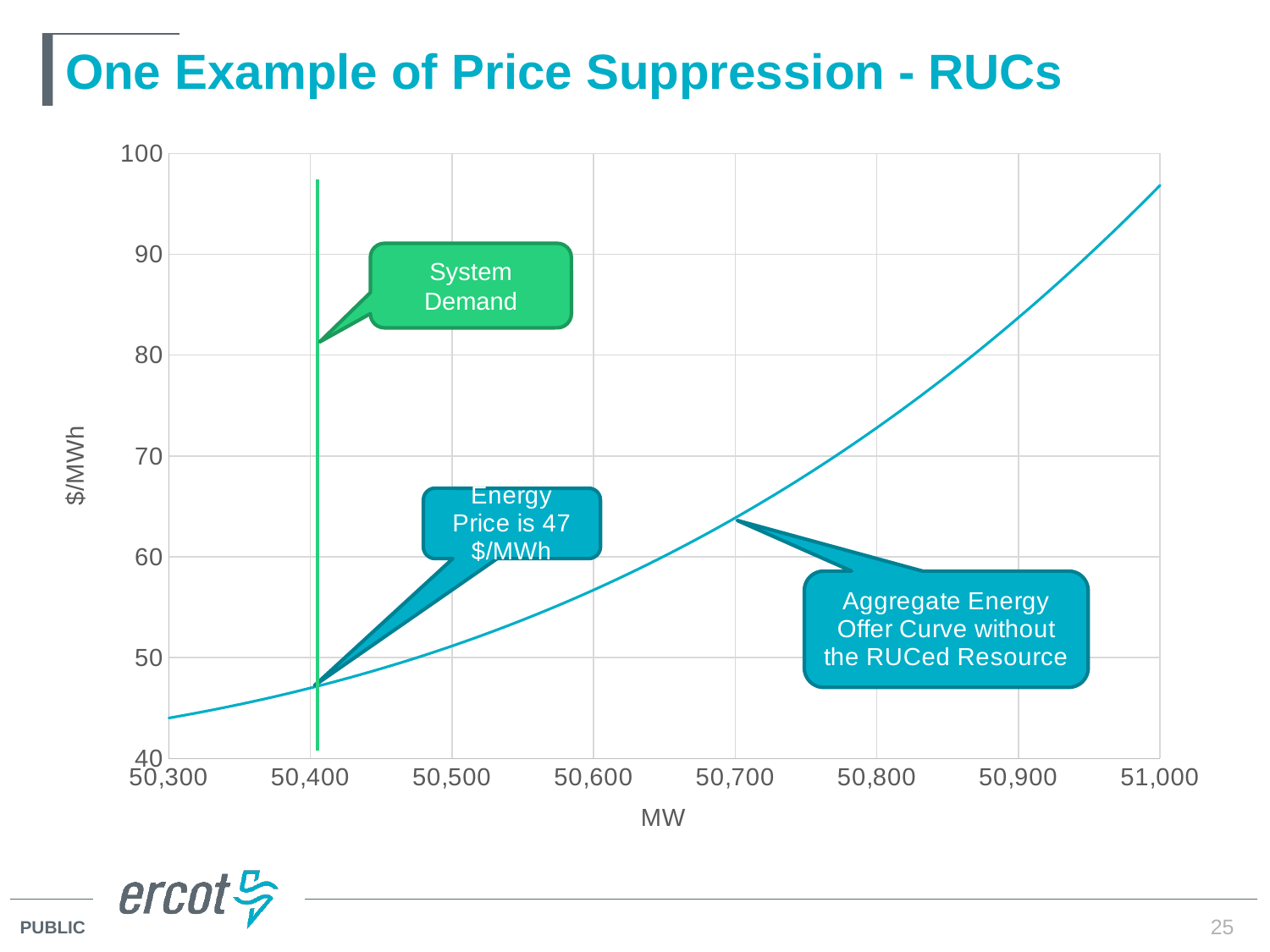
What is the label of the y axis? $/MWh What does the vertical green line on the chart represent, according to its callout? System Demand Is the value of the offer curve at 50,500 MW greater or less than 60 $/MWh? less What kind of chart is shown on the slide? line chart Is the value of the offer curve at 50,300 MW greater or less than 50 $/MWh? less How many tick labels are shown on the x axis? 8 Is the value of the offer curve at 51,000 MW greater or less than 90 $/MWh? greater Which is higher on the offer curve: the value at 50,800 MW or the value at 50,600 MW? 50,800 MW Does the Aggregate Energy Offer Curve rise or fall as MW increases along the x axis? rise According to the callout on the chart, what is the energy price at the system demand level? 47 $/MWh